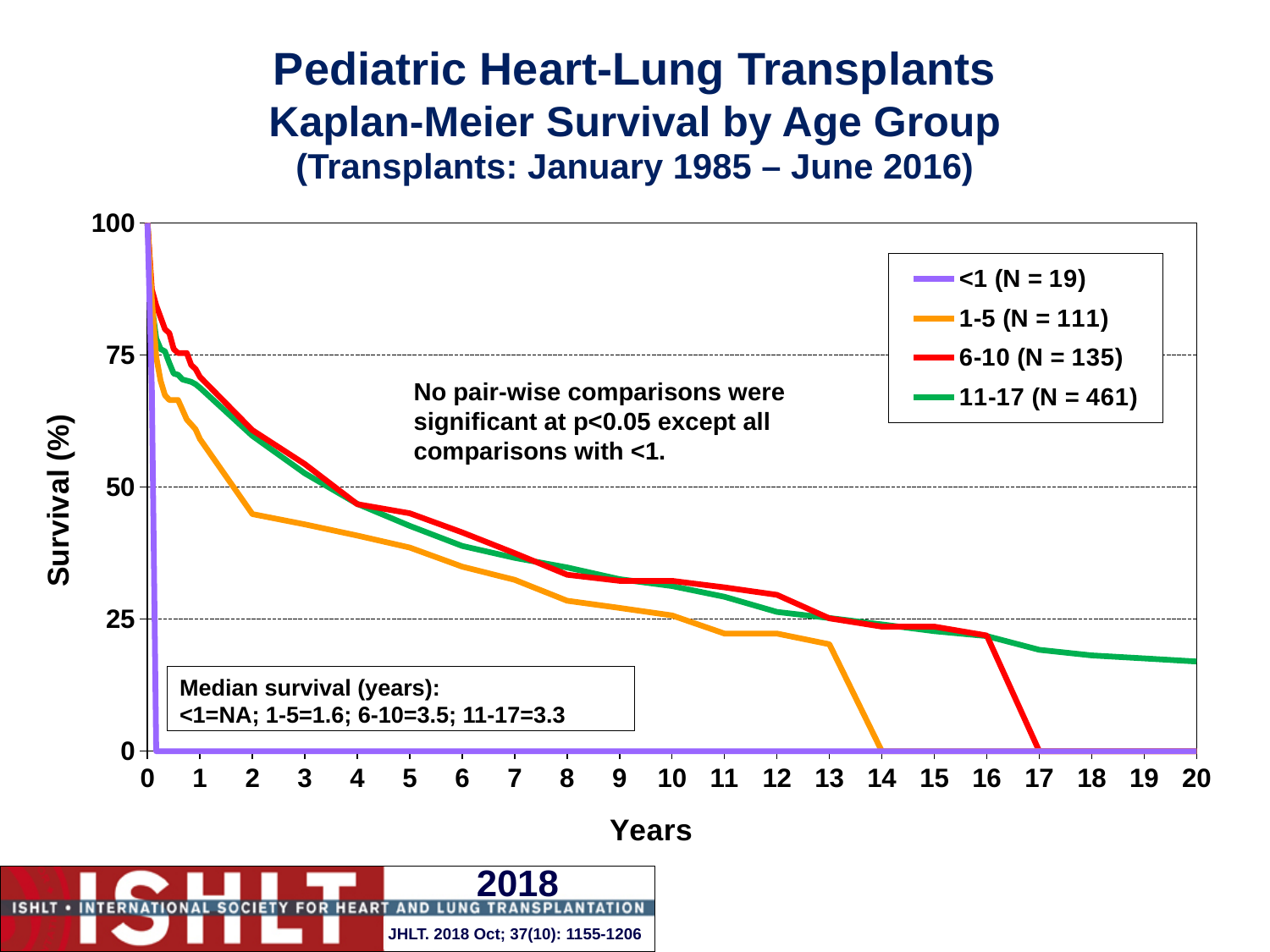
Which age group has the smallest N? <1 Is the survival value for the 11-17 group at 20 years greater or less than 25? less How many age groups (series) does the legend list? 4 What is the median survival in years for the 1-5 age group? 1.6 What is the difference in N between the 6-10 group and the 1-5 group? 24 What is the median survival in years for the 6-10 age group? 3.5 What is the N for the 11-17 age group shown in the legend? 461 Which age group has the largest N? 11-17 Which has the longer median survival, the 6-10 group or the 11-17 group? 6-10 What is the label on the y axis? Survival (%) What kind of chart is shown on the slide? line chart What is the N for the <1 age group shown in the legend? 19